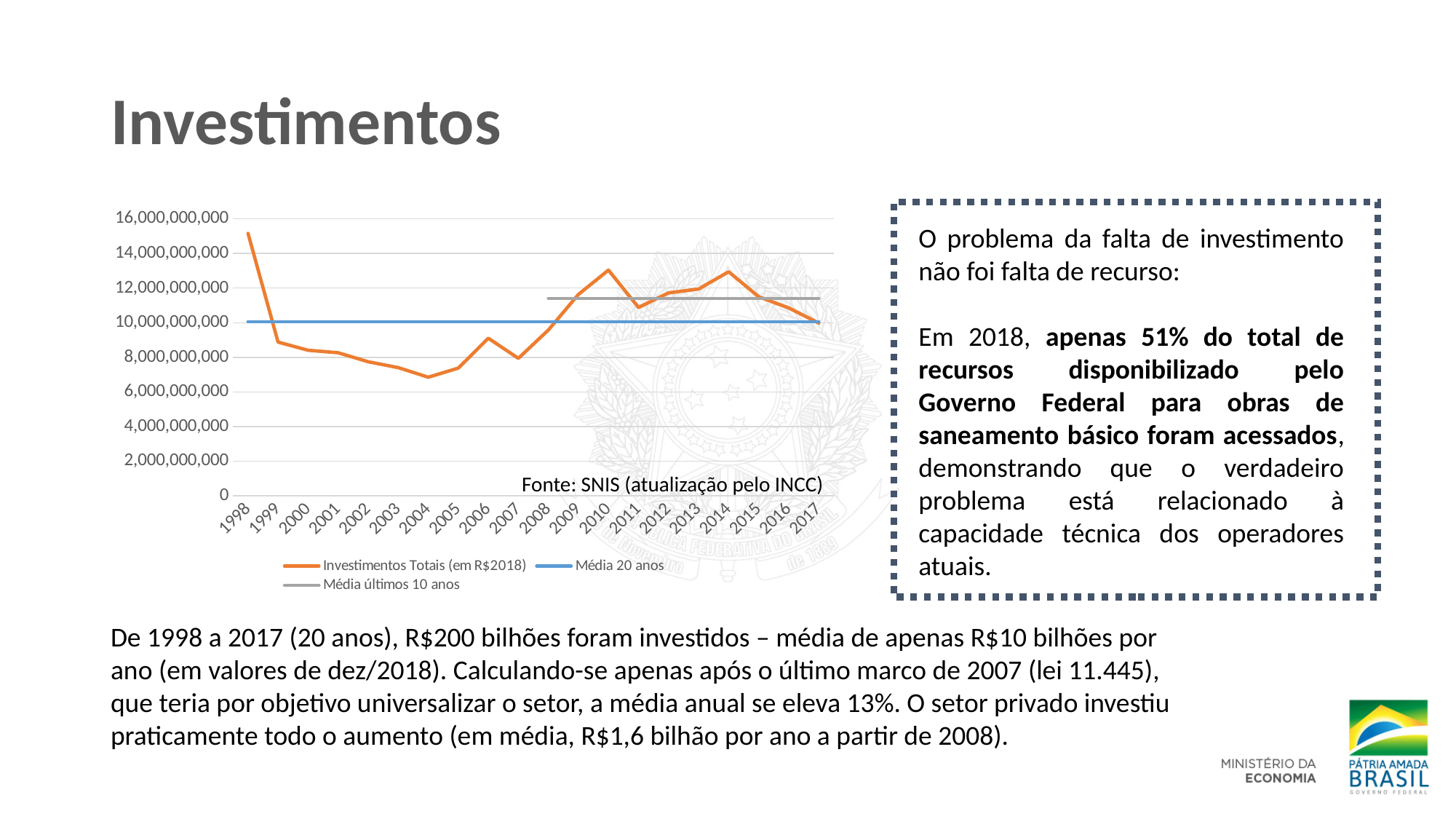
How many series does the chart legend list? 3 Is the value of Investimentos Totais (em R$2018) for 2004 greater or less than 8,000,000,000? less Do the values of Investimentos Totais (em R$2018) rise or fall from 1998 to 2004? fall Is the value of Investimentos Totais (em R$2018) for 1998 greater or less than 14,000,000,000? greater What is the source cited for the chart data? SNIS (atualização pelo INCC) Is the value of Investimentos Totais (em R$2018) for 2010 greater or less than 12,000,000,000? greater What kind of chart is shown on the slide? line chart In which year is the value of Investimentos Totais (em R$2018) lowest? 2004 Which year has a higher value of Investimentos Totais (em R$2018), 1998 or 2010? 1998 How many years are shown on the x axis of the chart? 20 In which year is the value of Investimentos Totais (em R$2018) highest? 1998